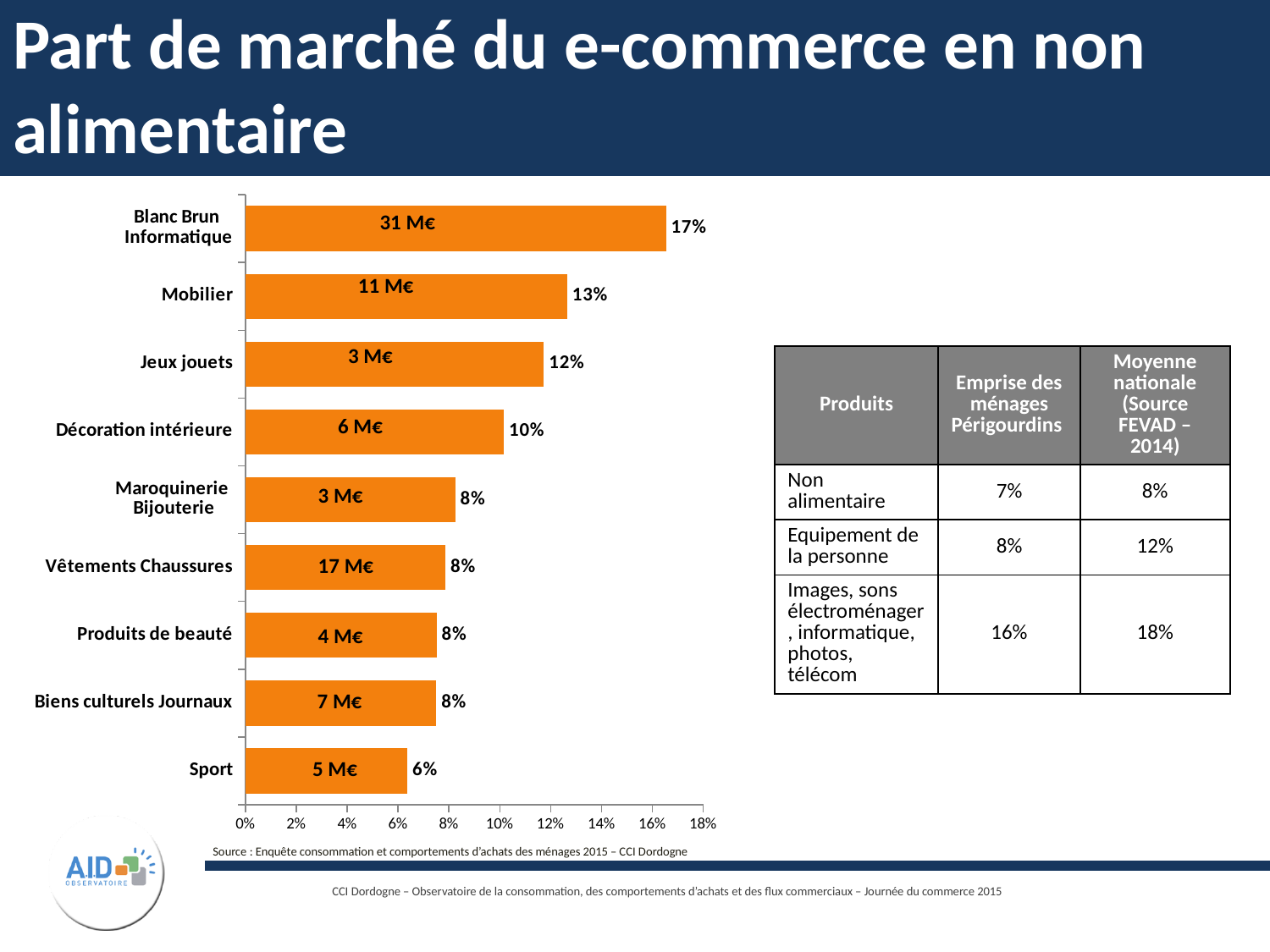
What amount in M€ is printed inside the bar for Blanc Brun Informatique? 31 M€ What is the difference in percentage points between Blanc Brun Informatique and Mobilier? 4 Which has a higher market share, Jeux jouets or Décoration intérieure? Jeux jouets Which category has the lowest market share percentage? Sport What kind of chart is shown on the slide? Bar chart What colour are the bars in the chart? Orange What is the e-commerce market share shown for Blanc Brun Informatique? 17% Which category has the highest market share percentage? Blanc Brun Informatique What is the value shown for Mobilier? 13% How many categories are shown in the bar chart? 9 What amount in M€ is printed inside the bar for Vêtements Chaussures? 17 M€ What is the percentage shown for Sport? 6%